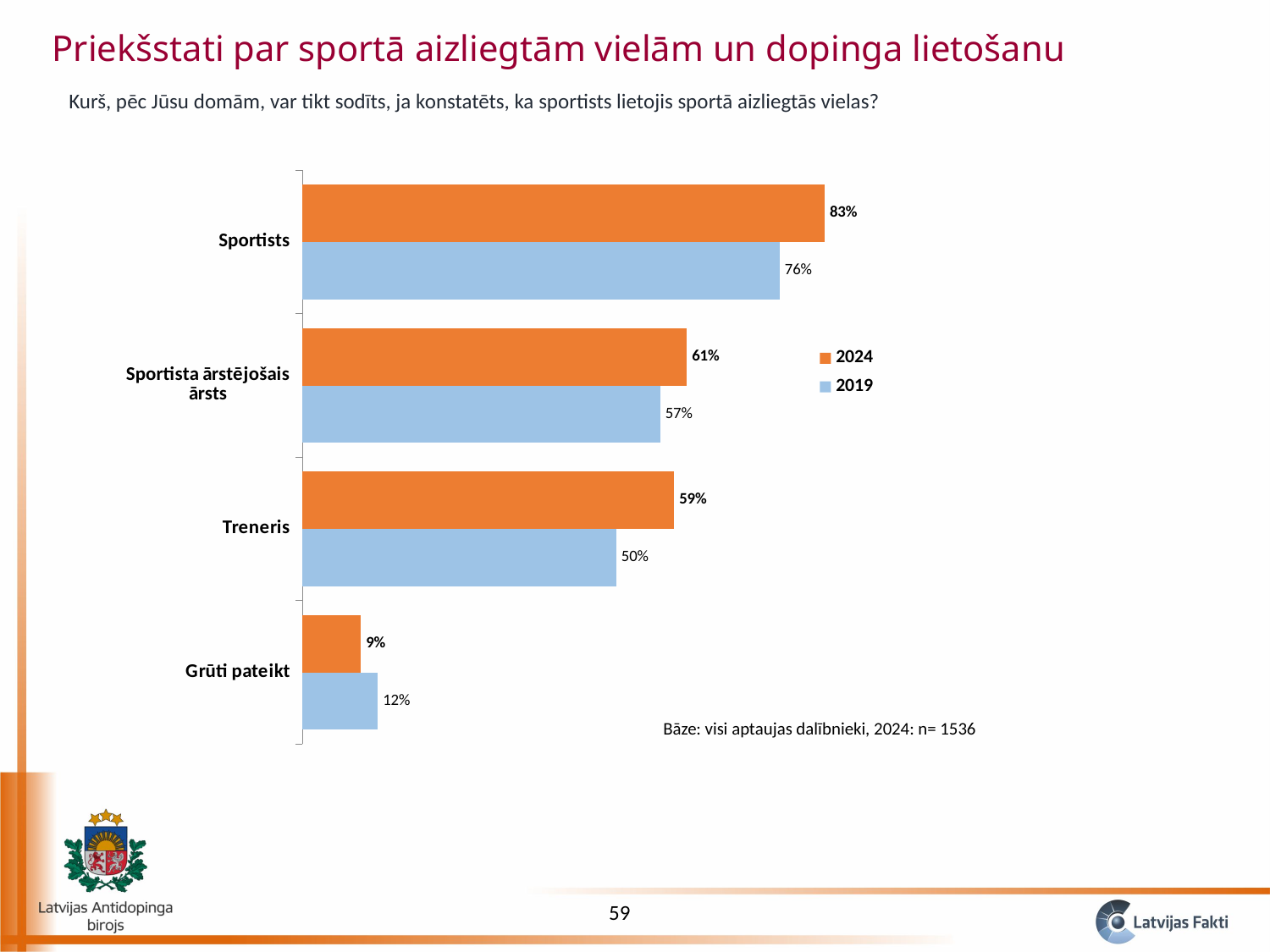
What is the difference between the 2024 and 2019 values for Treneris? 9% What kind of chart is shown on the slide? Bar chart What is the 2019 value for Treneris? 50% Which is larger for Grūti pateikt, the 2024 value or the 2019 value? 2019 Which category has the highest 2024 value? Sportists What is the 2024 value for Grūti pateikt? 9% Which category has the lowest 2019 value? Grūti pateikt How many series does the legend list? 2 What is the 2019 value for Sportista ārstējošais ārsts? 57% How many categories are shown in the chart? 4 What is the 2024 value for Sportists? 83% What is the difference between the 2024 and 2019 values for Sportists? 7%